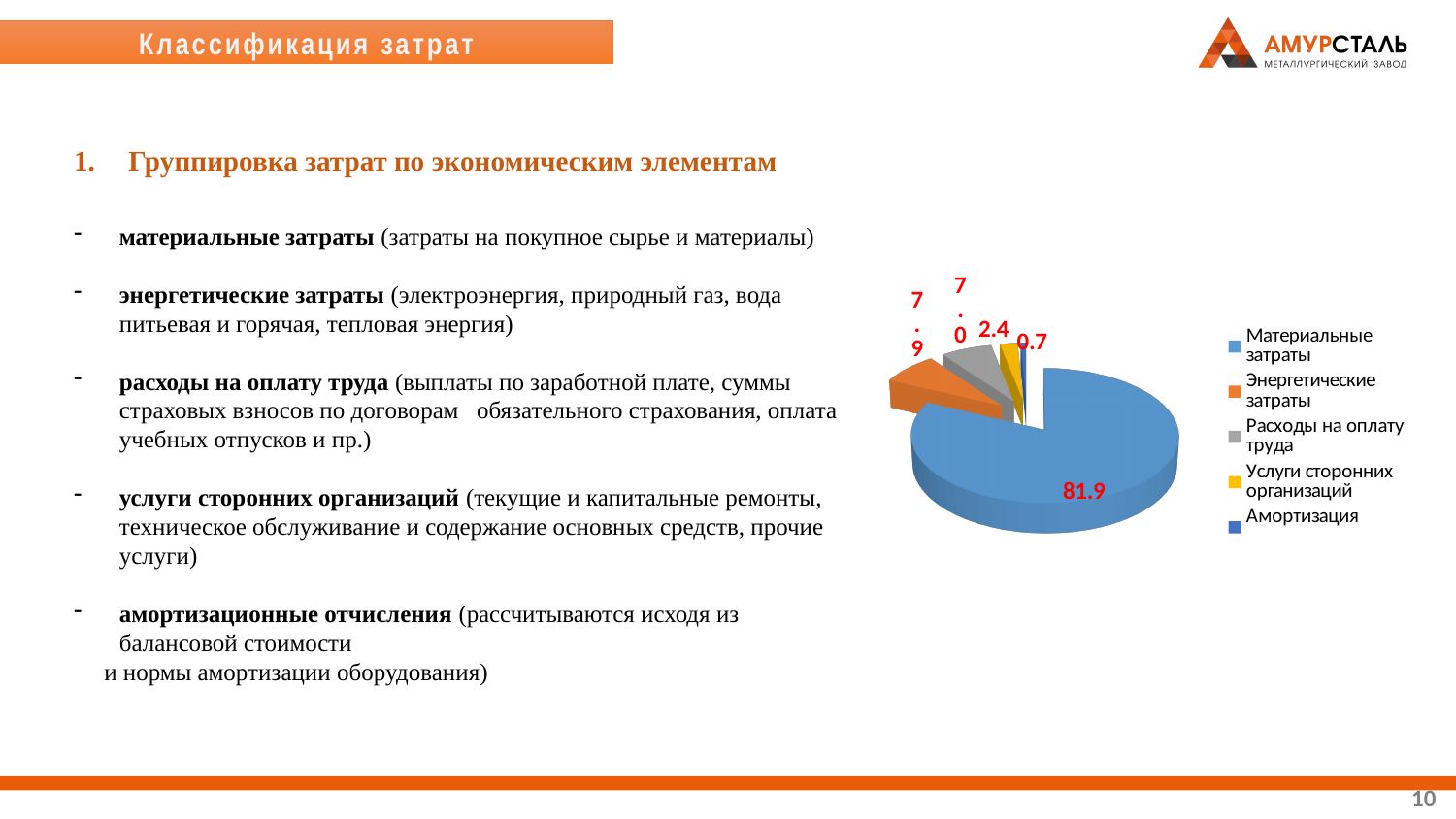
What is the value shown for Амортизация in the pie chart? 0.7 What is the value shown for Материальные затраты in the pie chart? 81.9 What is the value shown for Услуги сторонних организаций in the pie chart? 2.4 Which category has the smallest slice in the pie chart? Амортизация What is the difference between the values for Материальные затраты and Энергетические затраты? 74.0 Which category has the largest slice in the pie chart? Материальные затраты What type of chart is shown on the slide? Pie chart How many categories are shown in the pie chart? 5 What colour is the slice for Энергетические затраты? Orange What is the value shown for Расходы на оплату труда in the pie chart? 7.0 What is the value shown for Энергетические затраты in the pie chart? 7.9 Which is larger: the value for Услуги сторонних организаций or the value for Амортизация? Услуги сторонних организаций